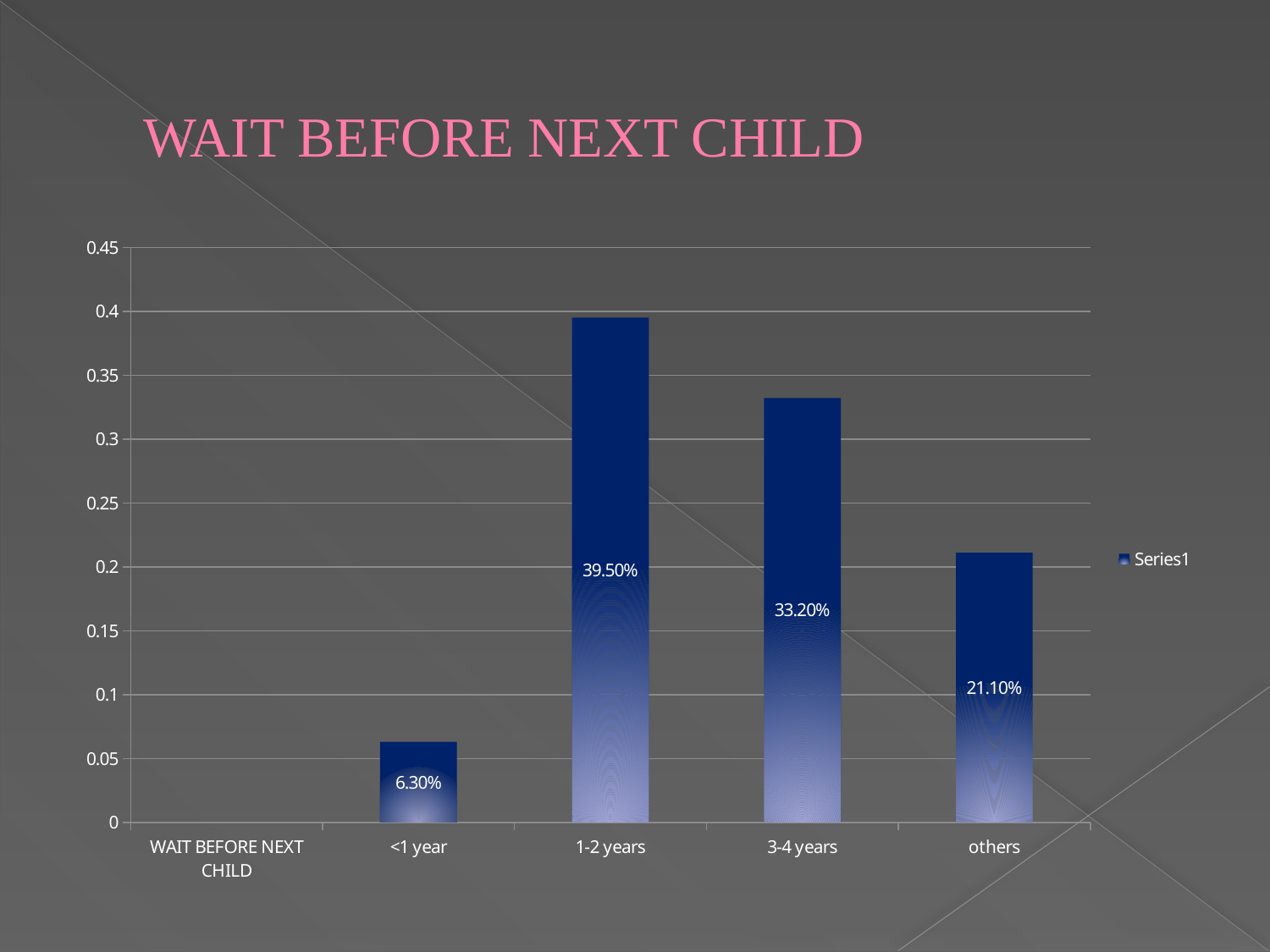
Which category has the lowest value? <1 year How many bars are plotted in the chart? 4 What is the value for the "<1 year" category? 6.30% What kind of chart is shown on the slide? bar chart What is the difference between the values for "3-4 years" and "others"? 12.10% What is the difference between the values for "1-2 years" and "3-4 years"? 6.30% What series name does the legend show? Series1 What is the value for the "1-2 years" category? 39.50% What is the value for the "3-4 years" category? 33.20% Which is larger, the value for "others" or the value for "<1 year"? others Which category has the highest value? 1-2 years What is the value for the "others" category? 21.10%